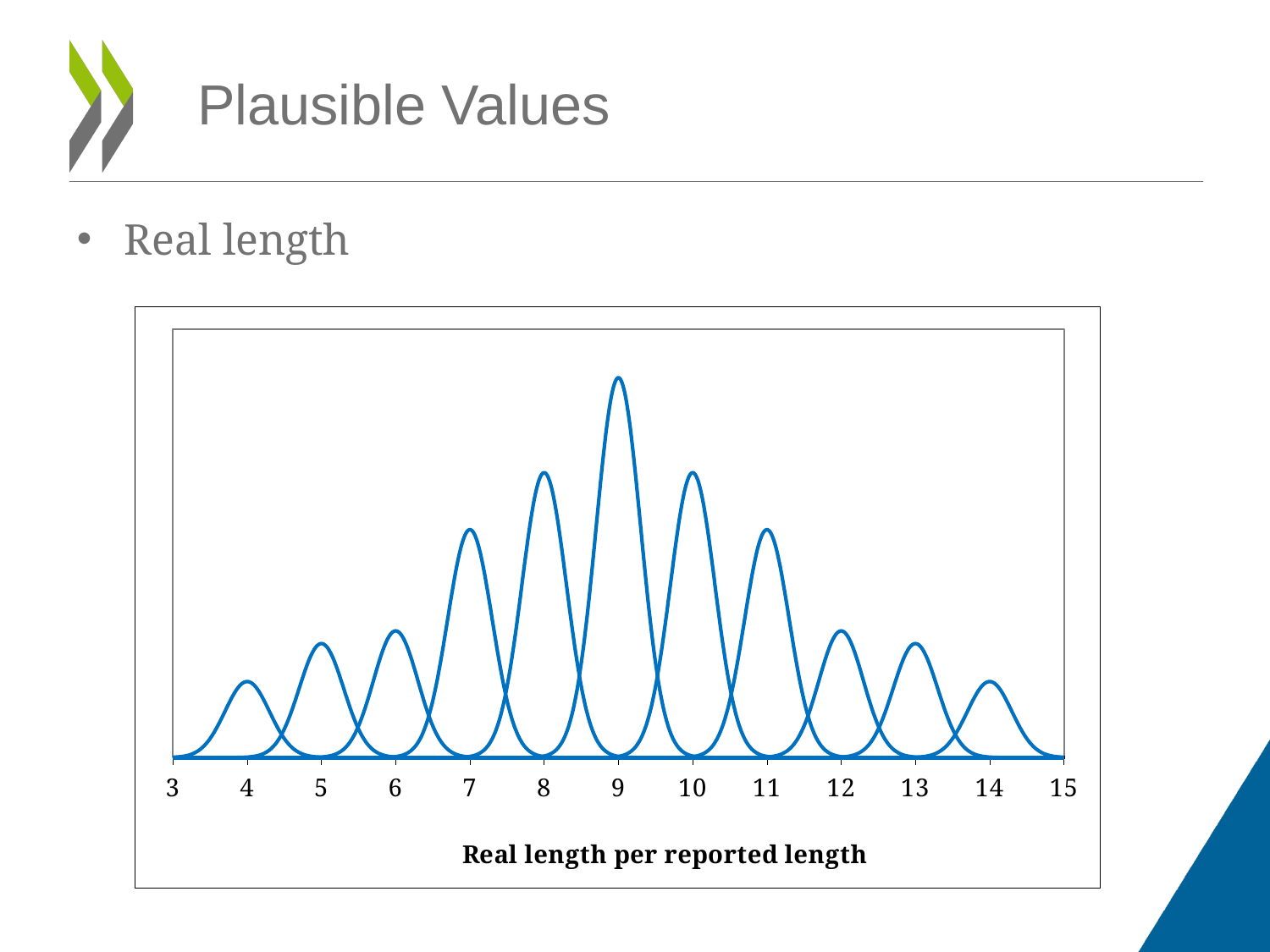
Which curve has the higher peak, the one centred at 9 or the one centred at 10? 9 Which curve has the higher peak, the one centred at 11 or the one centred at 13? 11 At which x-axis value is the tallest curve centred? 9 What is the x-axis title of the chart? Real length per reported length Which curve has the higher peak, the one centred at 7 or the one centred at 8? 8 How many bell-shaped curves are plotted on the chart? 11 Do the peaks of the curves rise or fall as the x-axis goes from 4 to 9? rise What is the lowest value labelled on the x axis? 3 Do the peaks of the curves rise or fall as the x-axis goes from 9 to 14? fall What kind of chart is shown on the slide? line chart